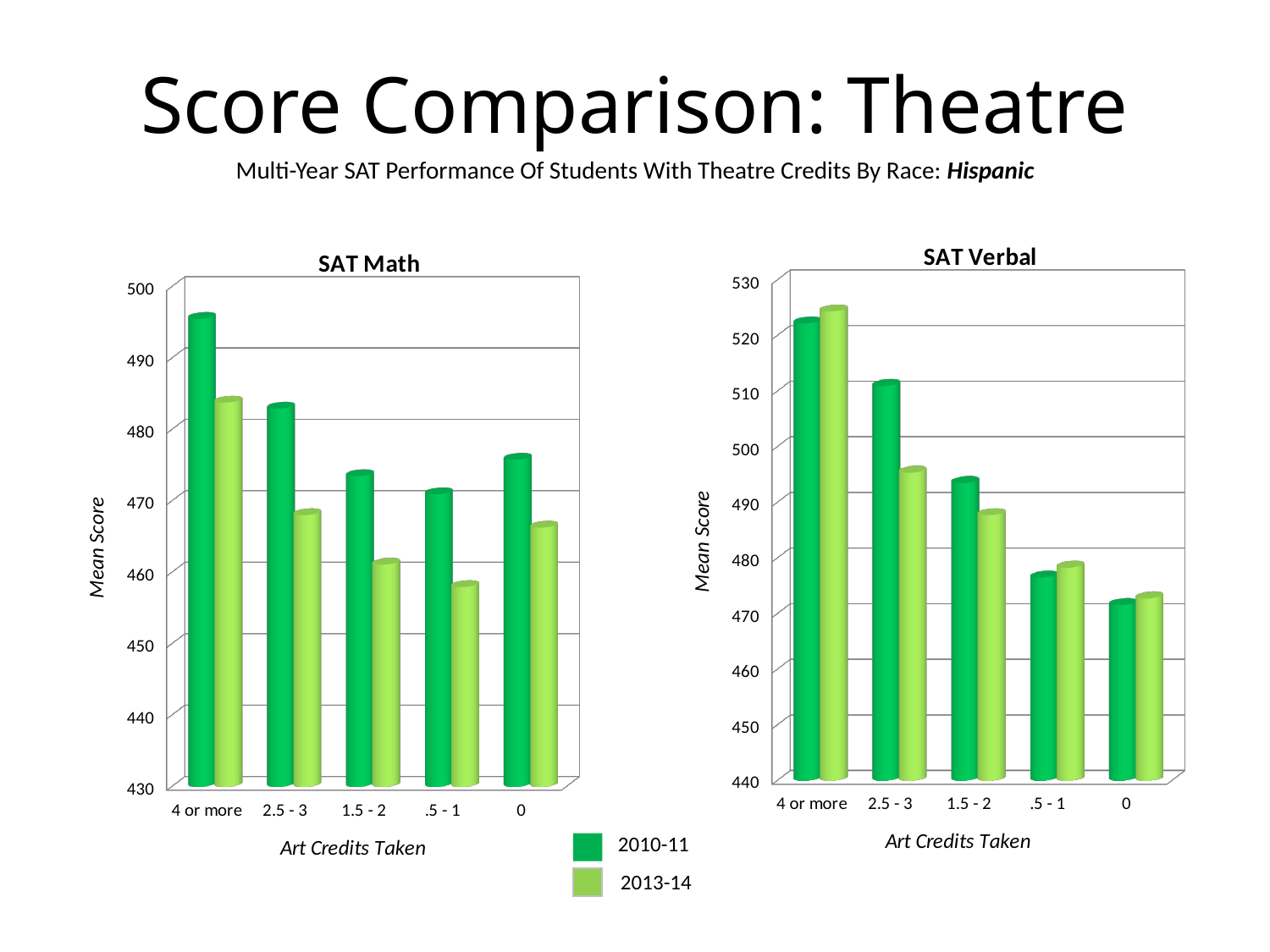
How many series does the legend list for the charts? 2 In the SAT Math chart, for the '2.5 - 3' category, which series has the larger score, 2010-11 or 2013-14? 2010-11 What is the y-axis label on the SAT Verbal chart? Mean Score In the SAT Math chart, is the 2010-11 score for '4 or more' greater or less than 490? greater What kind of chart is the SAT Math chart? bar chart In the SAT Math chart, which art-credit category has the lowest 2013-14 score? .5 - 1 How many art-credit categories are shown on the x axis of the SAT Verbal chart? 5 In the SAT Verbal chart, do the 2010-11 scores rise or fall moving from '4 or more' to '0' along the x axis? fall In the SAT Verbal chart, which art-credit category has the lowest 2010-11 score? 0 In the SAT Verbal chart, is the 2013-14 score for '2.5 - 3' greater or less than 500? less In the SAT Verbal chart, which art-credit category has the highest 2013-14 score? 4 or more In the SAT Math chart, which art-credit category has the highest 2010-11 score? 4 or more